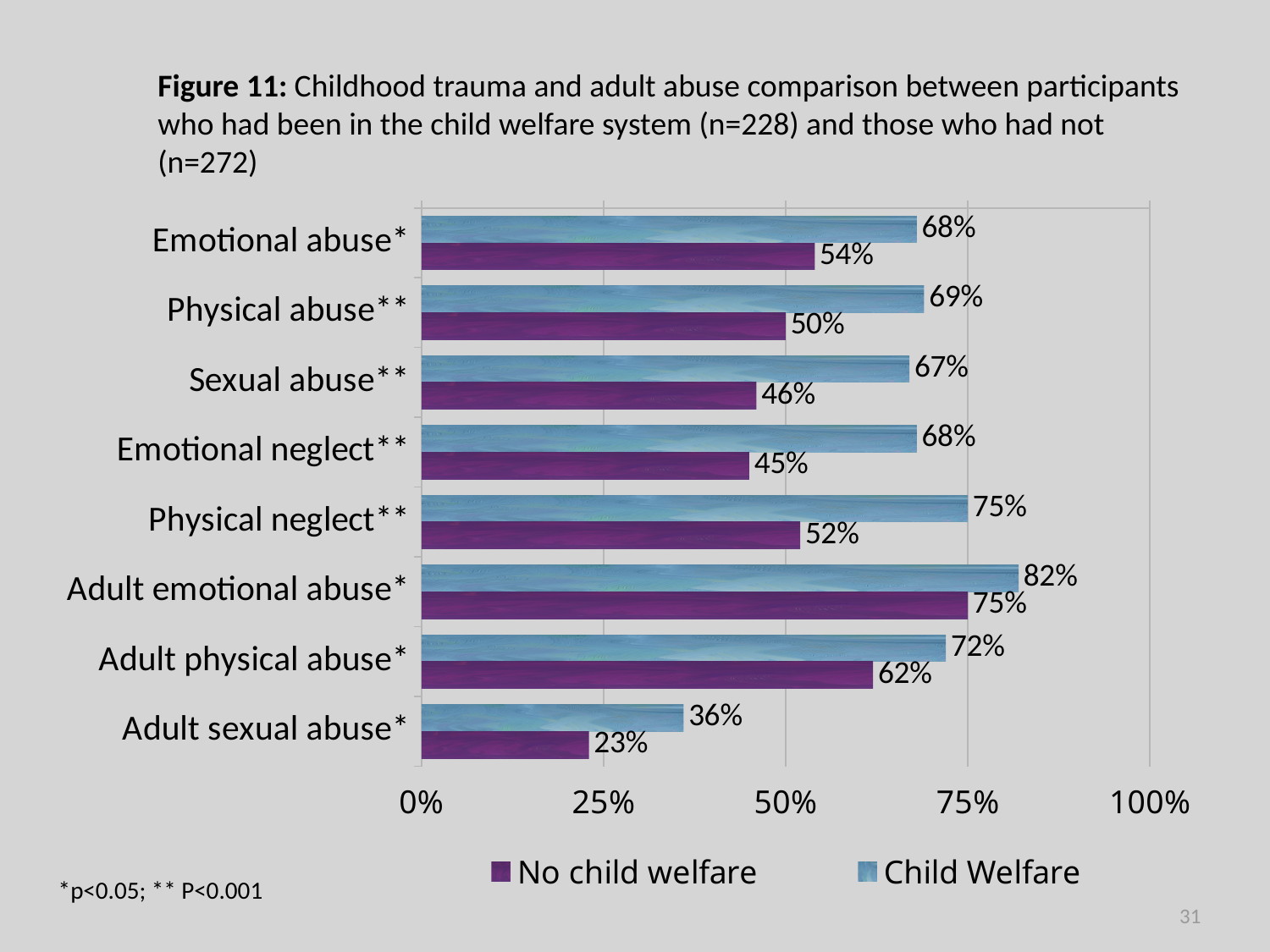
What is the No child welfare value for Adult sexual abuse*? 23% What is the difference between the Child Welfare and No child welfare values for Adult emotional abuse*? 7% How many categories are shown on the chart? 8 Which is larger for Sexual abuse**: the Child Welfare value or the No child welfare value? Child Welfare What is the difference between the Child Welfare and No child welfare values for Emotional neglect**? 23% What kind of chart is shown on the slide? Bar chart What is the Child Welfare value for Physical neglect**? 75% Which series is shown in purple? No child welfare How many series does the legend list? 2 Which category has the lowest No child welfare value? Adult sexual abuse* What is the No child welfare value for Emotional neglect**? 45% Which category has the highest Child Welfare value? Adult emotional abuse*